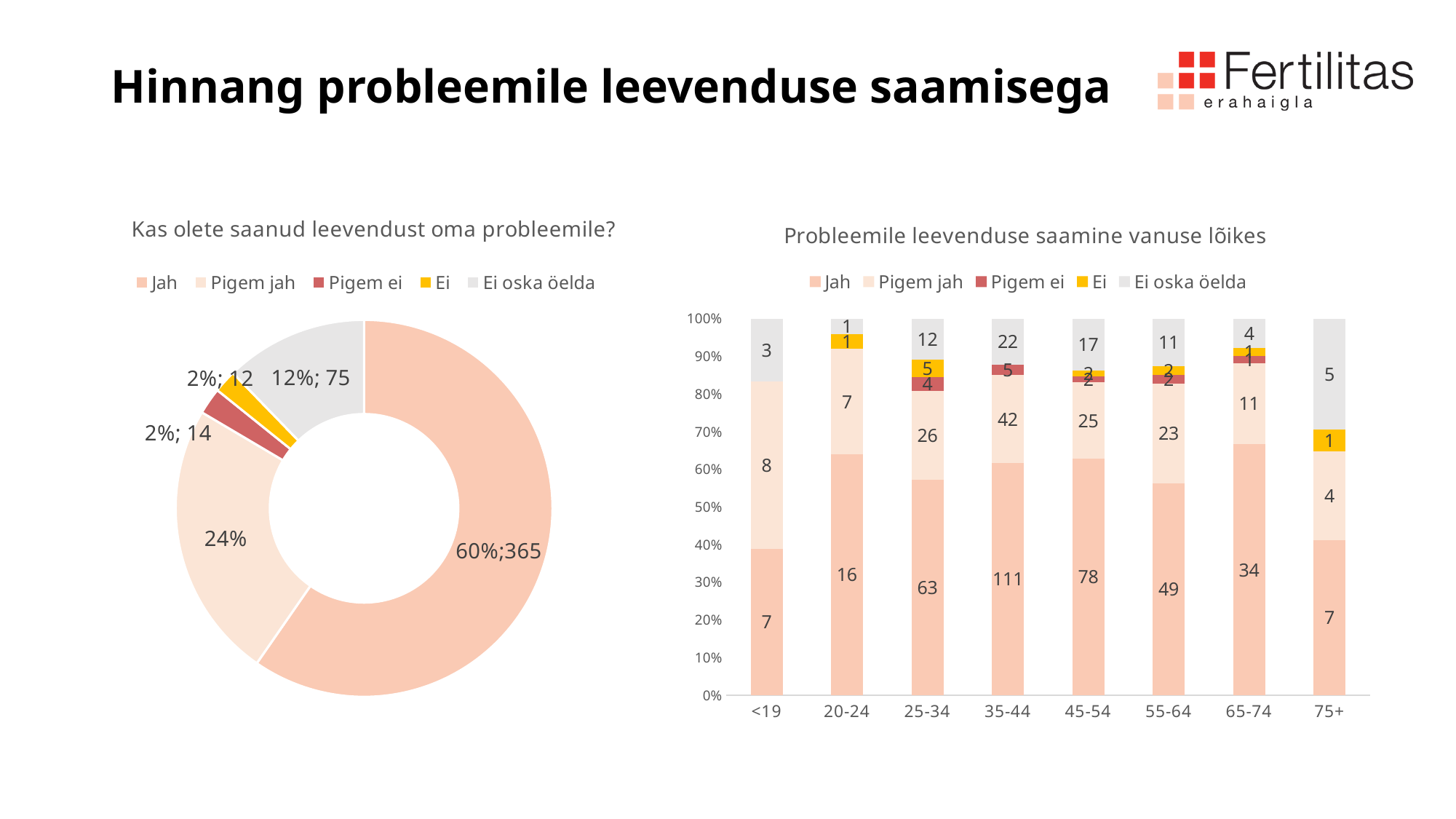
In the chart titled "Probleemile leevenduse saamine vanuse lõikes", how many age groups are shown on the x axis? 8 In the chart titled "Kas olete saanud leevendust oma probleemile?", how many responses are "Ei oska öelda"? 75 In the chart titled "Probleemile leevenduse saamine vanuse lõikes", which is larger: the "Ei oska öelda" value for 35-44 or for 65-74? 35-44 In the chart titled "Probleemile leevenduse saamine vanuse lõikes", what kind of chart is shown? Stacked bar chart In the chart titled "Kas olete saanud leevendust oma probleemile?", what kind of chart is shown? Donut (pie) chart In the chart titled "Probleemile leevenduse saamine vanuse lõikes", what is the difference between the "Jah" values for the 25-34 and 55-64 age groups? 14 In the chart titled "Kas olete saanud leevendust oma probleemile?", which category has the largest share? Jah In the chart titled "Probleemile leevenduse saamine vanuse lõikes", what is the "Jah" value for the 35-44 age group? 111 In the chart titled "Probleemile leevenduse saamine vanuse lõikes", which age group has the highest "Jah" value? 35-44 In the chart titled "Kas olete saanud leevendust oma probleemile?", what share of responses is "Jah"? 60% In the chart titled "Kas olete saanud leevendust oma probleemile?", how many entries does the legend list? 5 In the chart titled "Probleemile leevenduse saamine vanuse lõikes", what is the "Pigem jah" value for the 45-54 age group? 25